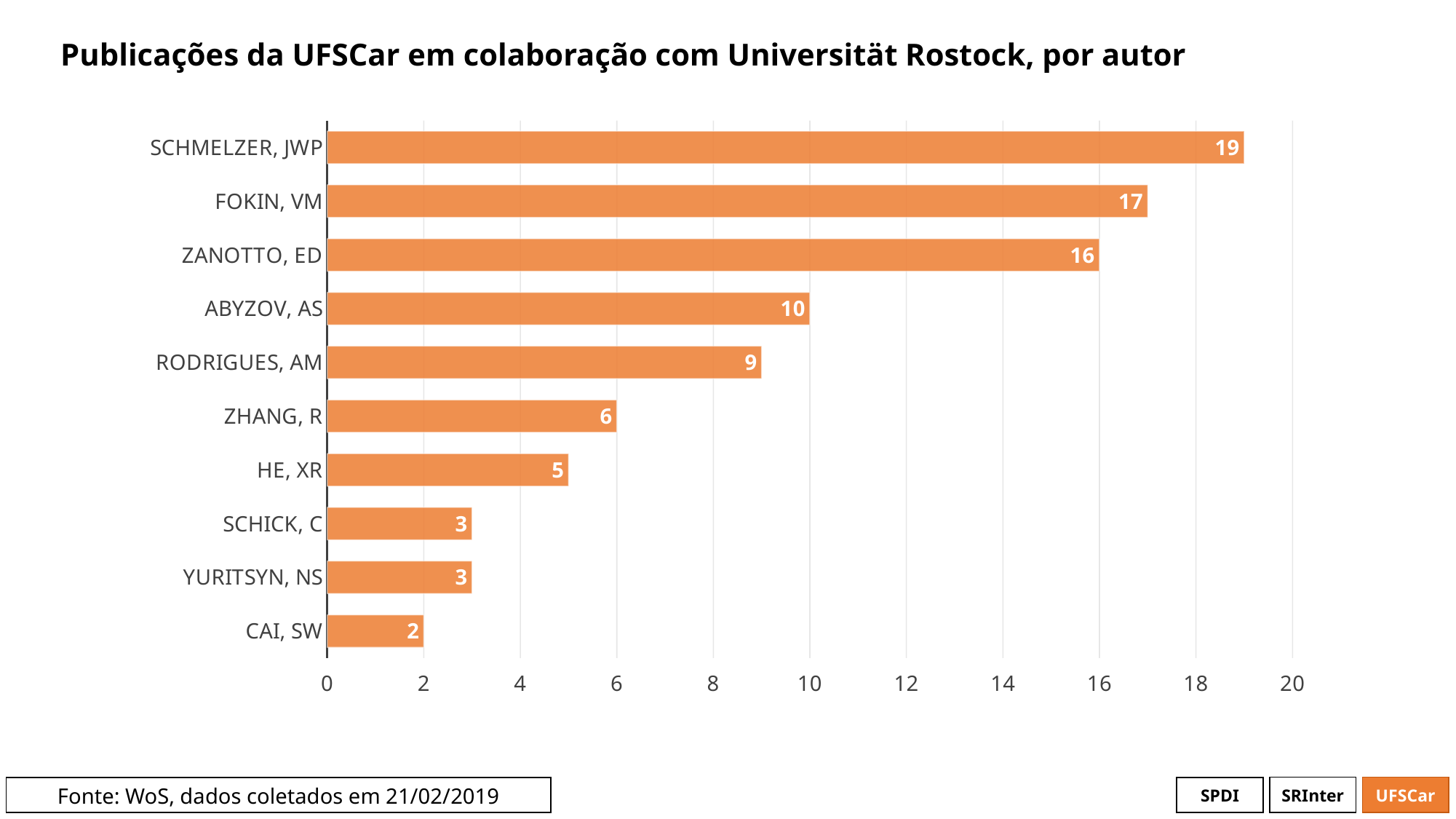
Which author has the lowest number of publications? CAI, SW What kind of chart is shown on the slide? bar chart How many authors are shown in the chart? 10 What is the value shown for ABYZOV, AS? 10 What is the value shown for HE, XR? 5 How many publications does SCHMELZER, JWP have? 19 What is the title of the chart? Publicações da UFSCar em colaboração com Universität Rostock, por autor What is the difference between the values for RODRIGUES, AM and ZHANG, R? 3 What is the difference between the values for FOKIN, VM and ZANOTTO, ED? 1 Which has a larger value, ABYZOV, AS or RODRIGUES, AM? ABYZOV, AS Is the value for ZANOTTO, ED greater or less than 14? greater Which author has the highest number of publications? SCHMELZER, JWP